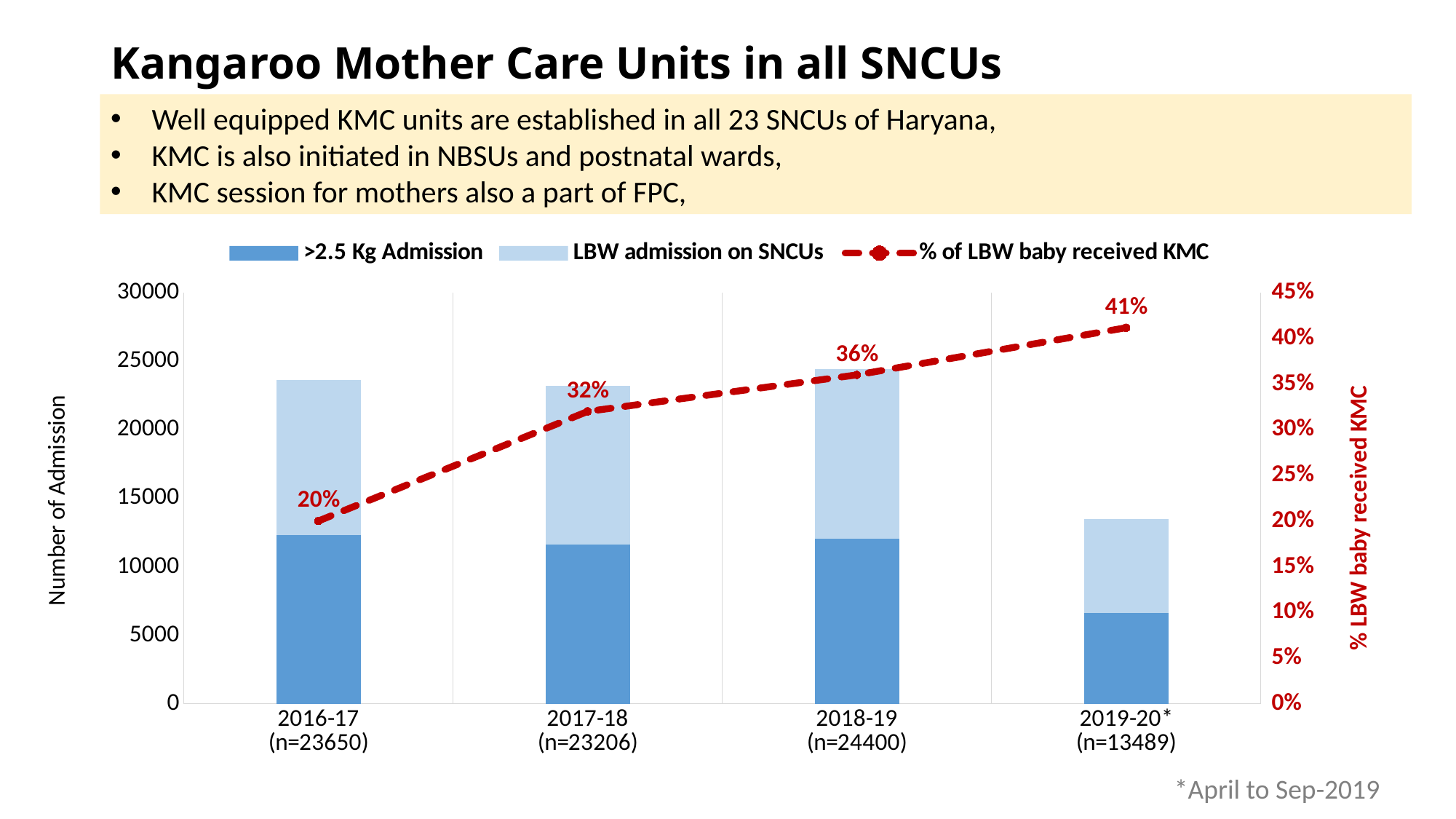
Which year has the lowest % of LBW baby received KMC? 2016-17 What percentage of LBW babies received KMC in 2017-18? 32% By how many percentage points did the % of LBW baby received KMC increase from 2016-17 to 2019-20*? 21 percentage points Does the % of LBW baby received KMC rise or fall across the years shown? rise What percentage of LBW babies received KMC in 2019-20*? 41% Which year has the highest % of LBW baby received KMC? 2019-20* Is the >2.5 Kg Admission value for 2016-17 greater or less than 10000? greater How many years are shown on the x axis? 4 Which year has the larger total number of admissions, 2018-19 or 2019-20*? 2018-19 How many series does the legend list? 3 Is the total admission bar for 2019-20* greater or less than 15000? less What percentage of LBW babies received KMC in 2016-17? 20%